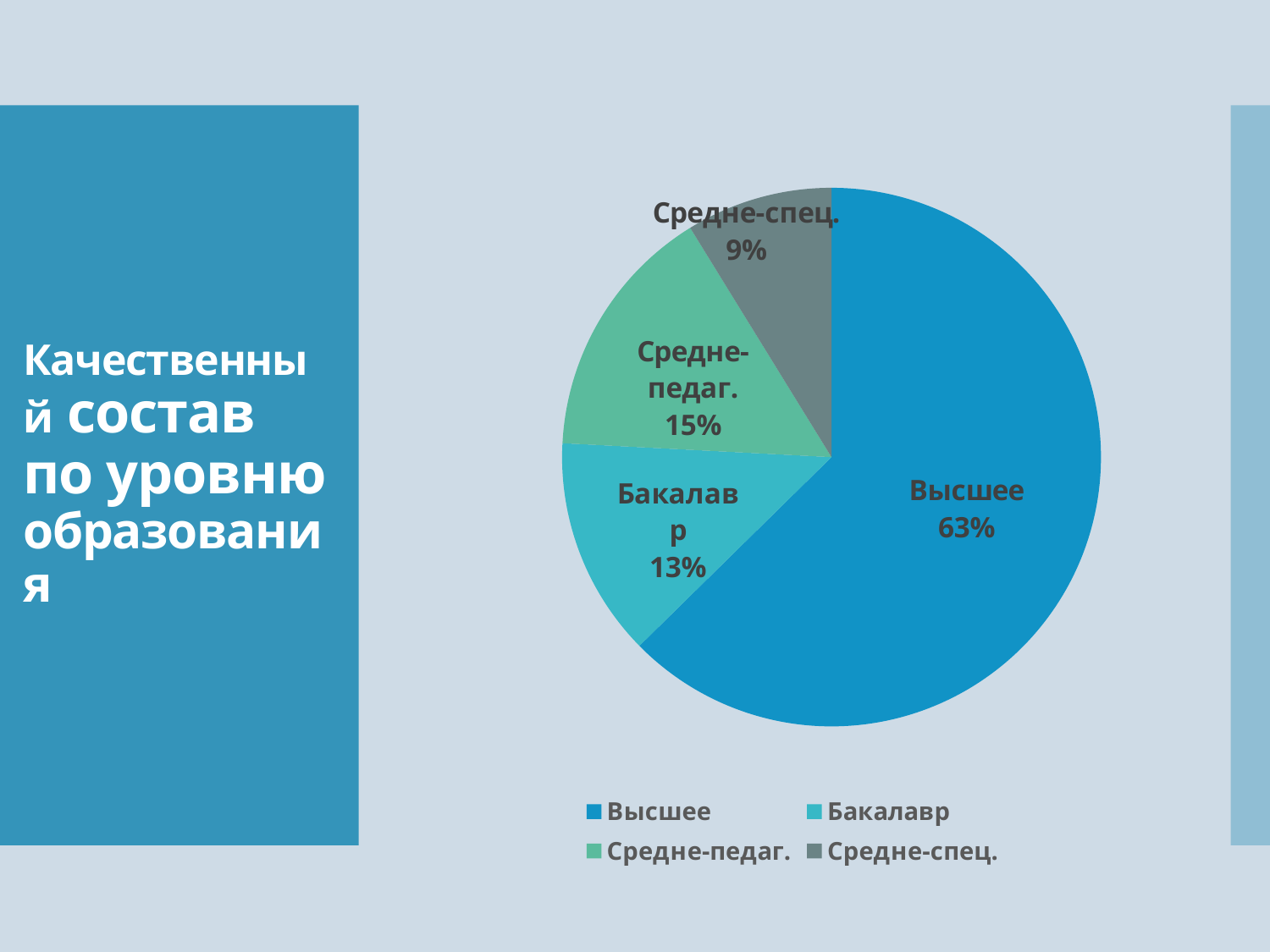
What is the value shown for Бакалавр? 13% Which category has the smallest slice? Средне-спец. What is the difference between the Высшее and Бакалавр shares? 50% What is the value shown for Средне-педаг.? 15% Which category has the largest slice? Высшее What is the value shown for Средне-спец.? 9% Which is larger, Средне-педаг. or Бакалавр? Средне-педаг. What share of the pie does Высшее have? 63% What is the difference between the Средне-педаг. and Средне-спец. shares? 6% What kind of chart is shown on the slide? pie chart How many entries does the legend list? 4 How many categories does the pie chart have? 4